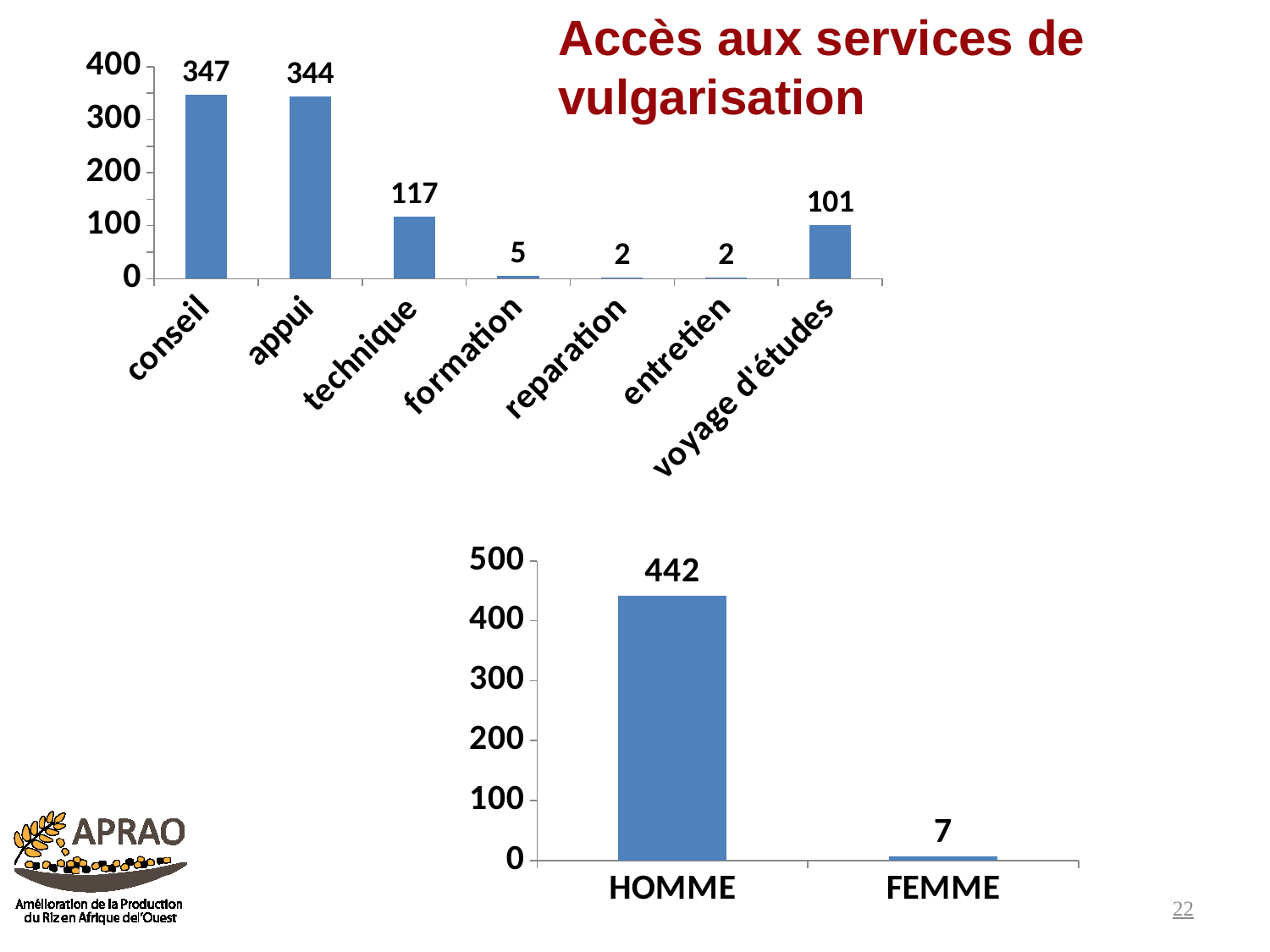
In the top chart, what is the value for technique? 117 In the top chart, what is the value for conseil? 347 In the bottom chart, what is the value for FEMME? 7 What type of chart is the bottom chart? bar chart In the bottom chart, what is the value for HOMME? 442 In the top chart, what is the difference between conseil and appui? 3 In the top chart, which category has the highest value? conseil In the top chart, which is larger, technique or voyage d'études? technique In the top chart, how many categories are shown on the x axis? 7 In the top chart, what is the value for formation? 5 In the top chart, what is the value for voyage d'études? 101 In the bottom chart, what is the difference between HOMME and FEMME? 435